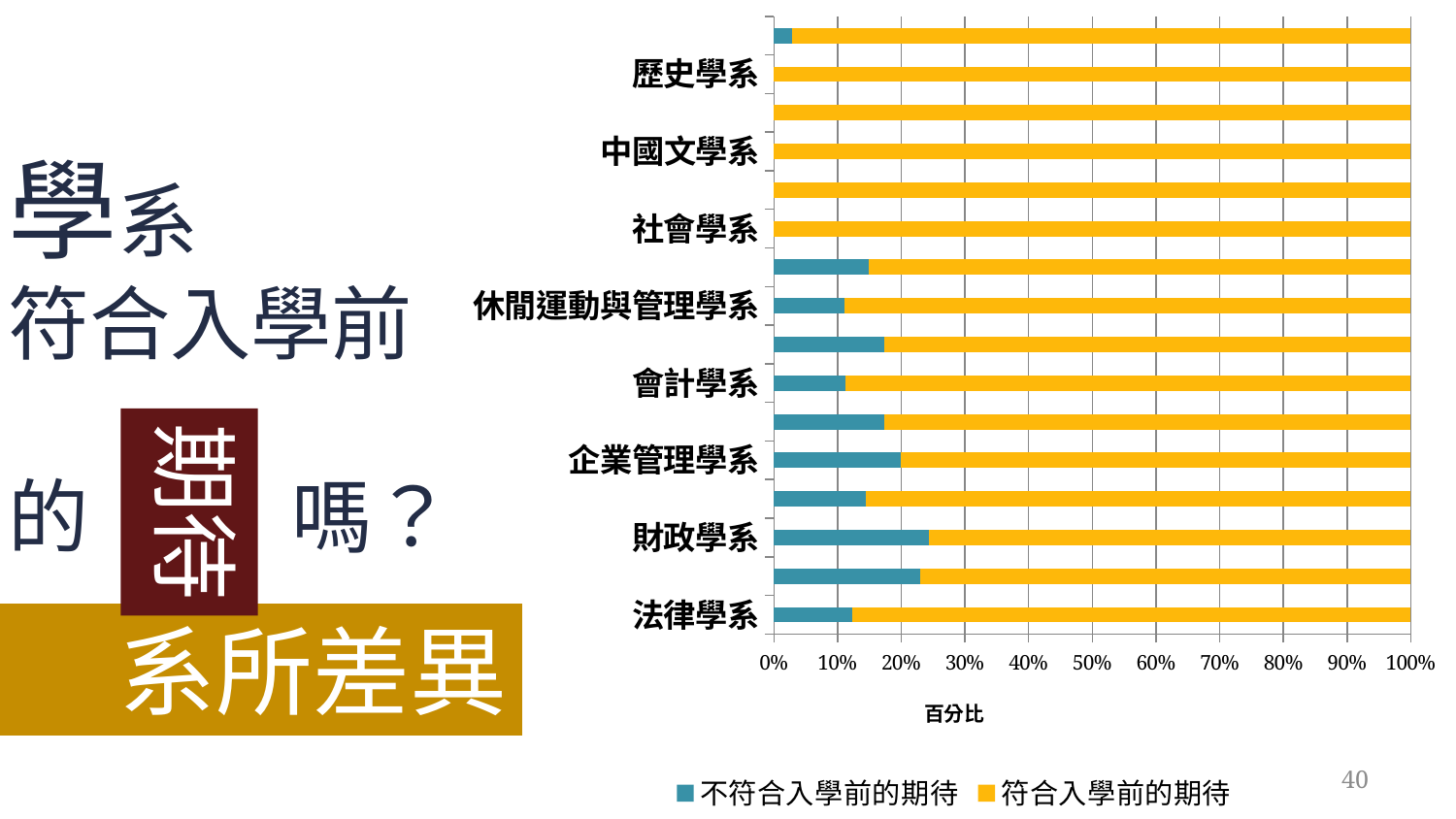
Which has the larger 符合入學前的期待 share, 社會學系 or 財政學系? 社會學系 Is the 符合入學前的期待 value for 歷史學系 greater or less than 90%? greater Is the 不符合入學前的期待 value for 會計學系 greater or less than 20%? less Which has the larger 不符合入學前的期待 share, 企業管理學系 or 會計學系? 企業管理學系 Is the 不符合入學前的期待 value for 財政學系 greater or less than 20%? greater How many series does the chart legend list? 2 What are the two series named in the chart legend? 不符合入學前的期待 and 符合入學前的期待 Which has the larger 不符合入學前的期待 share, 財政學系 or 法律學系? 財政學系 What kind of chart is shown on the slide? bar chart What is the title of the horizontal axis of the chart? 百分比